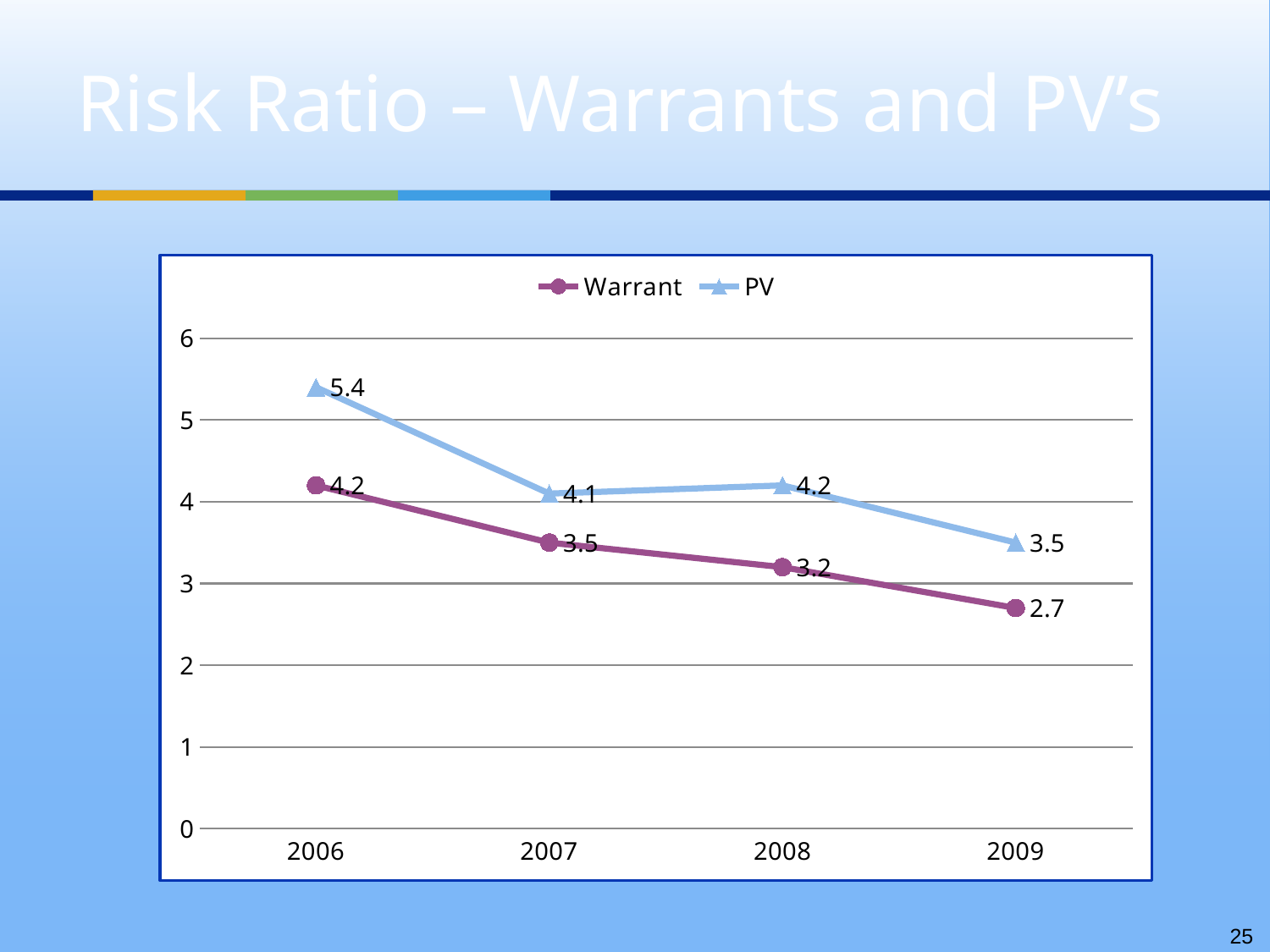
What is the PV value for 2007? 4.1 Is the Warrant value for 2009 greater or less than 3? less In which year is the Warrant series lowest? 2009 Does the Warrant series rise or fall from 2006 to 2009? fall What kind of chart is shown on the slide? line chart In which year is the PV series highest? 2006 What is the PV value for 2009? 3.5 Which is larger in 2008, the PV value or the Warrant value? PV How many years are shown on the x axis? 4 What is the Warrant value for 2006? 4.2 What is the difference between the PV and Warrant values in 2006? 1.2 How many series does the legend list? 2